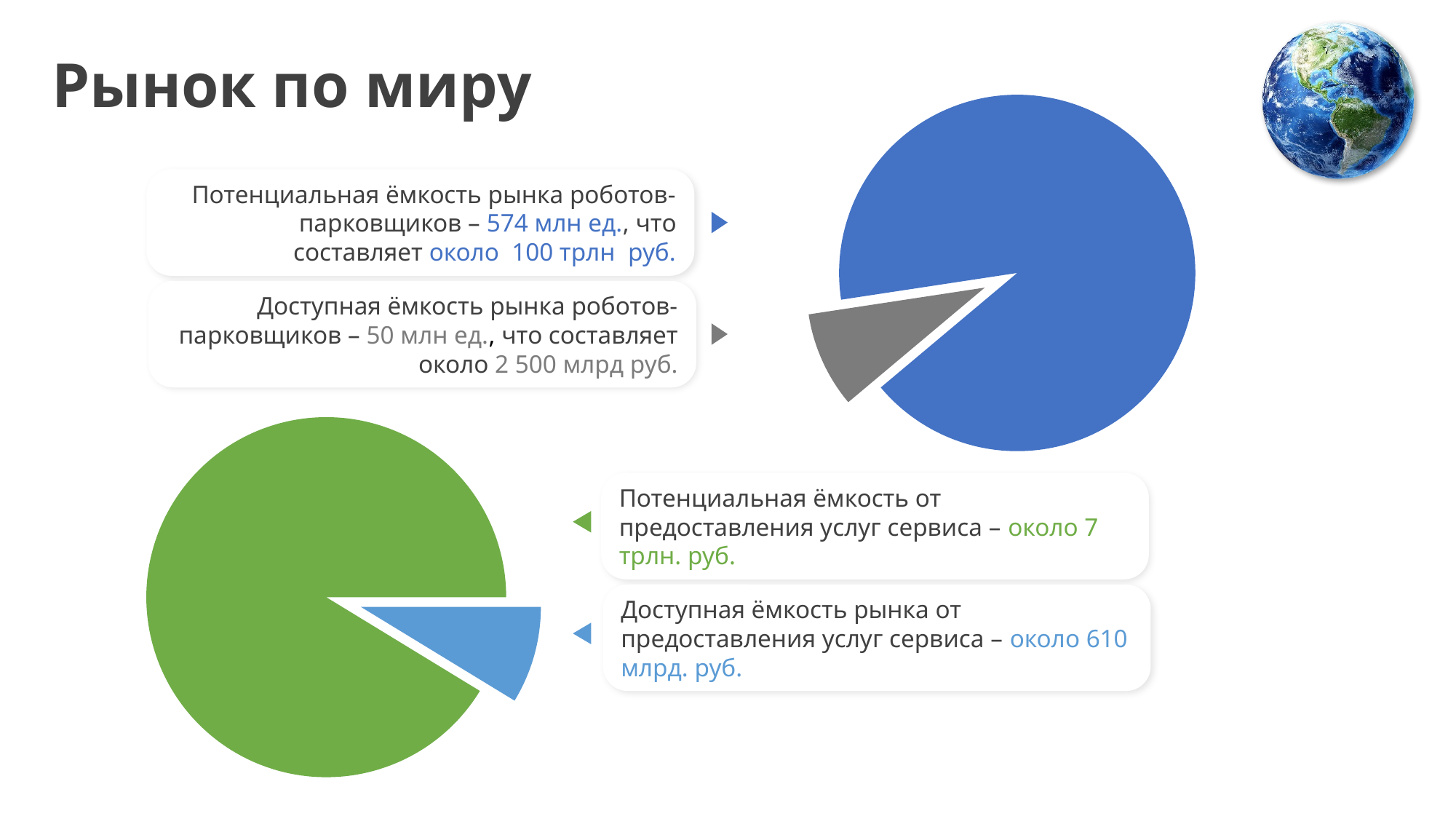
According to the text next to the top-right pie chart, what is the available market capacity of parking robots in units? 50 млн ед. What kind of chart is the chart in the top right of the slide? pie chart What colour is the larger slice of the top-right pie chart? blue For the top-right pie chart, what is the difference in units between the potential market capacity (574 млн ед.) and the available market capacity (50 млн ед.)? 524 млн ед. According to the text next to the top-right pie chart, what is the potential market capacity of parking robots in units? 574 млн ед. How many slices does the top-right pie chart have? 2 What kind of chart is the chart in the bottom left of the slide? pie chart In the top-right pie chart, which slice is larger, the blue one or the grey one? the blue one What colour is the smaller slice of the bottom-left pie chart? light blue How many slices does the bottom-left pie chart have? 2 In the bottom-left pie chart, which slice is larger, the green one or the light blue one? the green one For the top-right pie chart, which is larger in units: the potential market capacity (574 млн ед.) or the available market capacity (50 млн ед.)? the potential market capacity